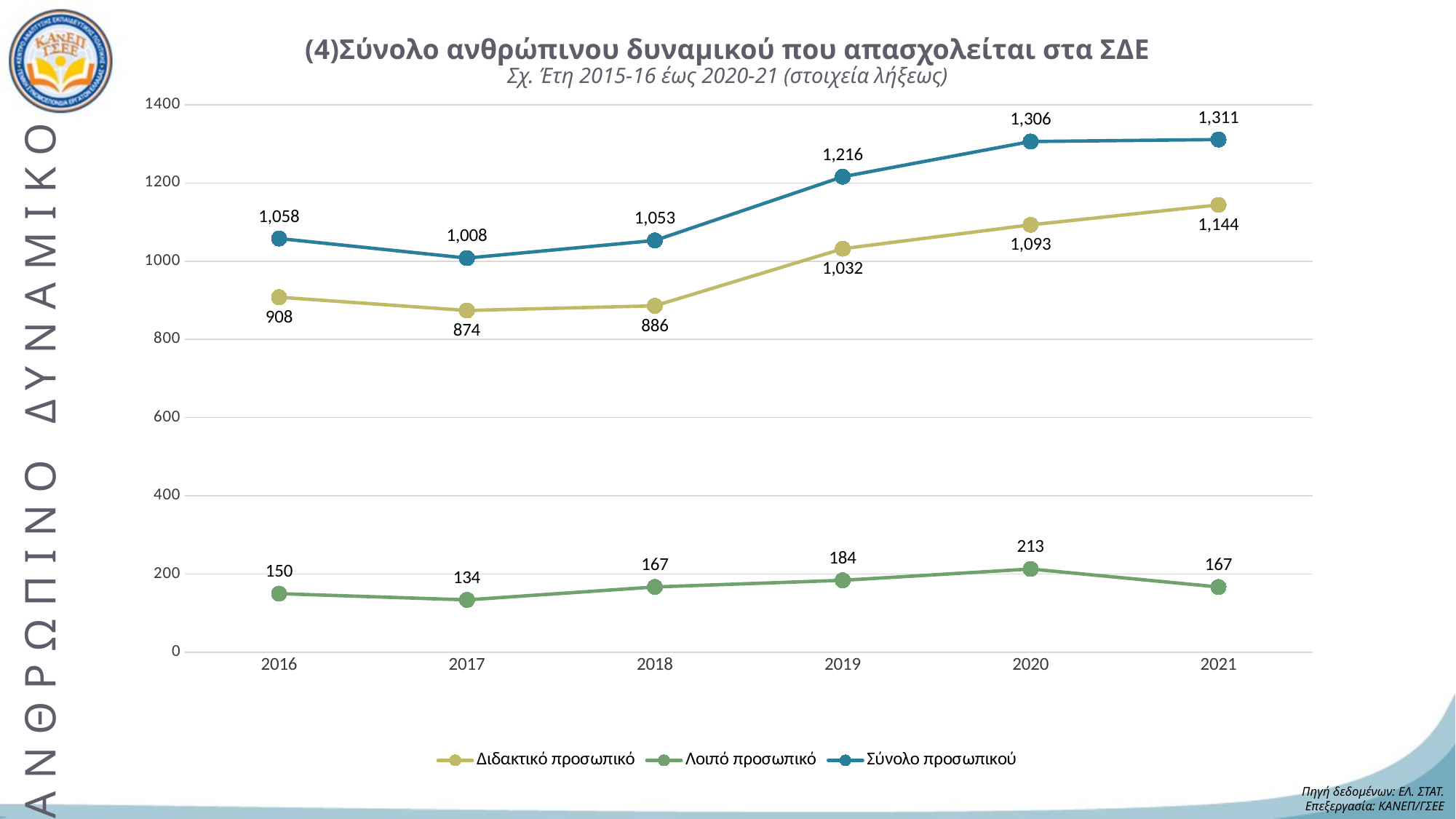
How many years are shown on the x axis? 6 What is the difference between Σύνολο προσωπικού in 2021 and in 2016? 253 In which year is Λοιπό προσωπικό lowest? 2017 What type of chart is shown on the slide? line chart What is the value of Διδακτικό προσωπικό in 2017? 874 Which is larger: Διδακτικό προσωπικό in 2019 or Σύνολο προσωπικού in 2017? Διδακτικό προσωπικό in 2019 What is the value of Σύνολο προσωπικού in 2019? 1,216 What is the value of Λοιπό προσωπικό in 2020? 213 Does Διδακτικό προσωπικό rise or fall from 2018 to 2021? rise In which year is Σύνολο προσωπικού highest? 2021 Which series is drawn in green? Λοιπό προσωπικό How many series does the legend list? 3